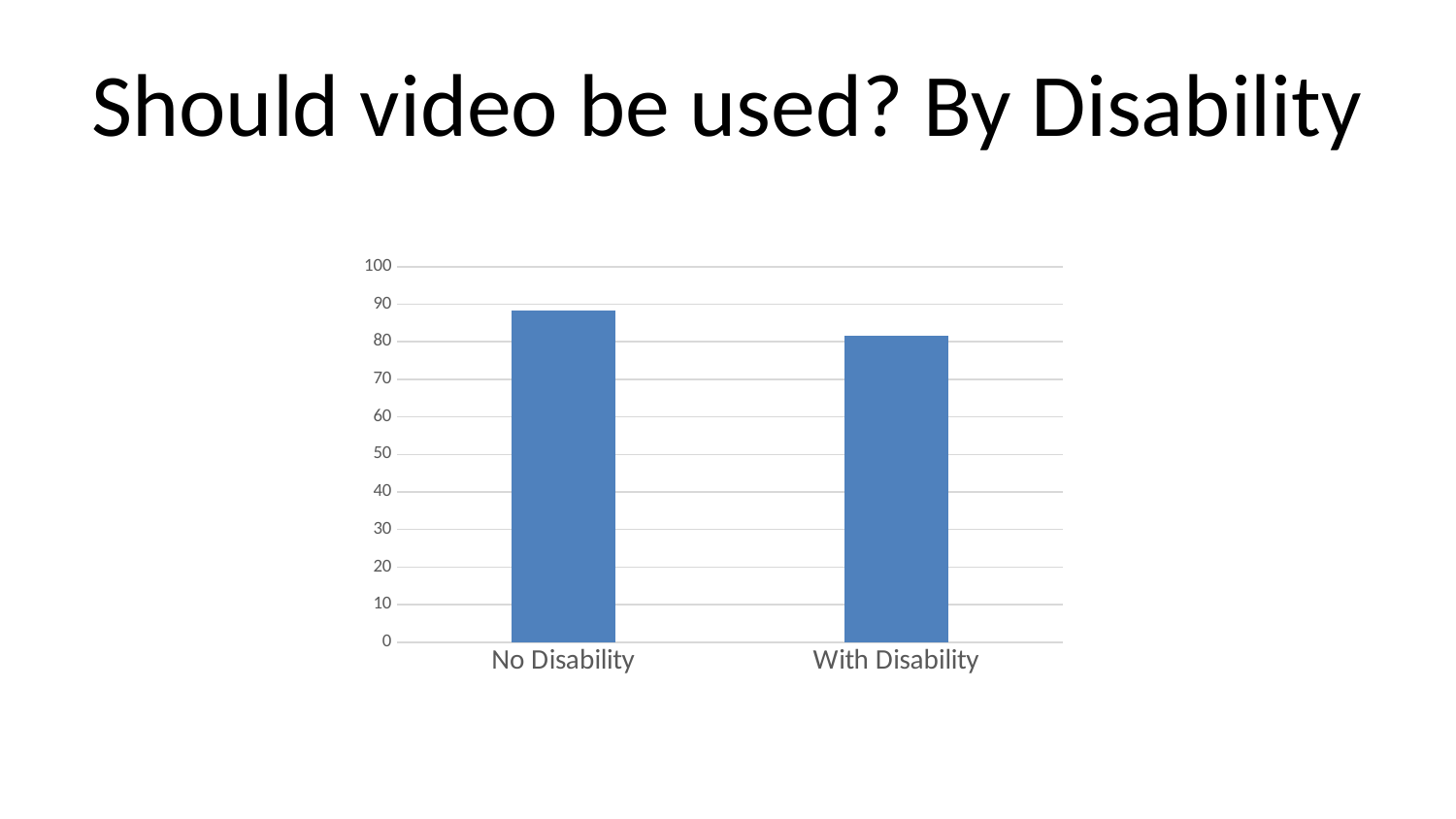
Which is larger, the value for No Disability or the value for With Disability? No Disability Is the value for No Disability greater or less than 90? less Is the value for With Disability greater or less than 70? greater Which category has the higher bar? No Disability Is the value for With Disability greater or less than 90? less What is the title of the slide containing the chart? Should video be used? By Disability How many categories are plotted in the chart? 2 What kind of chart is shown on the slide? bar chart Do the bar values rise or fall from left to right across the x axis? fall What is the maximum value shown on the vertical axis? 100 Which category has the lower bar? With Disability